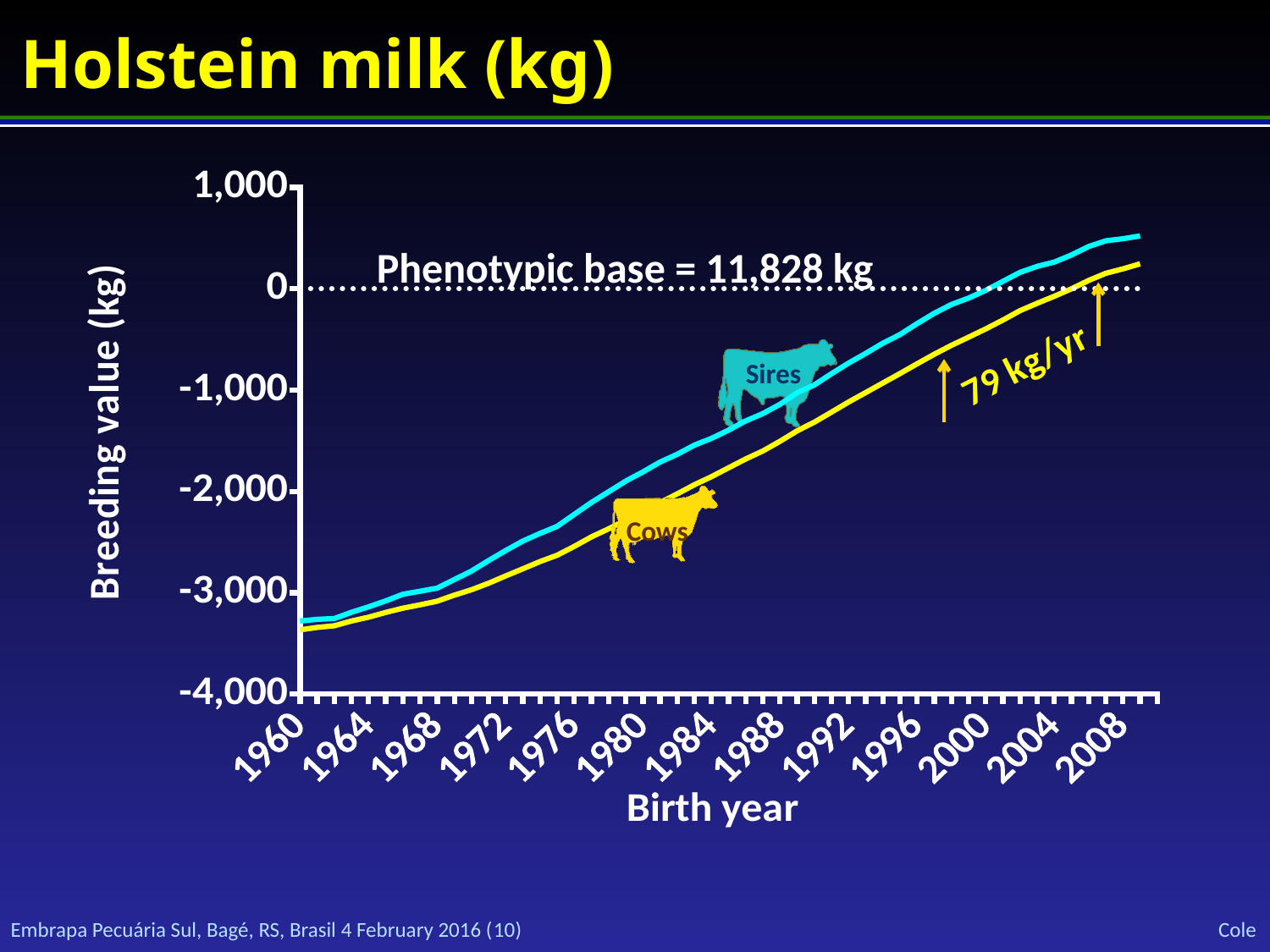
What is the phenotypic base stated on the chart? 11,828 kg Which series has the higher breeding value in birth year 2000, Sires or Cows? Sires Do the breeding values rise or fall as birth year increases from 1960 to 2008? rise Is the breeding value for Sires in 1960 greater or less than -3,000? less Is the breeding value for Cows in 2008 greater or less than 0? greater Is the breeding value for Sires in 1996 greater or less than -1,000? greater Which series lies above the other across the whole chart, Sires or Cows? Sires What kind of chart is shown on the slide? line chart How many series are plotted in the chart? 3 What rate of change is annotated next to the Cows line? 79 kg/yr